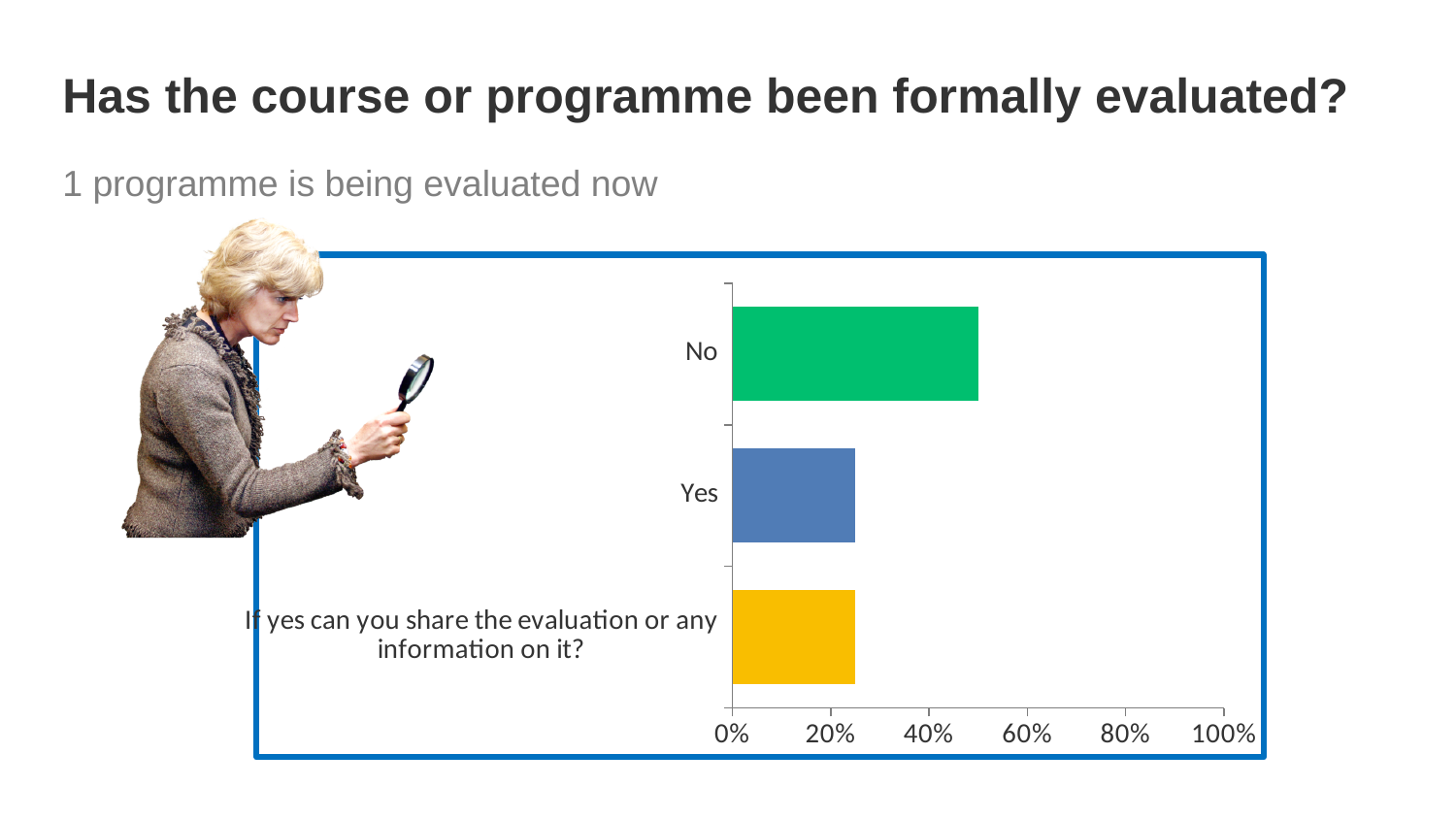
How many categories are plotted in the chart? 3 Is the value for No greater or less than 60%? less What is the highest value shown on the horizontal axis of the chart? 100% Which category has the highest value in the chart? No Is the value for Yes greater or less than 20%? greater Is the value for Yes greater or less than 40%? less What kind of chart is shown on the slide? bar chart What colour is the bar for the No category? green Which is larger, the value for No or the value for Yes? No